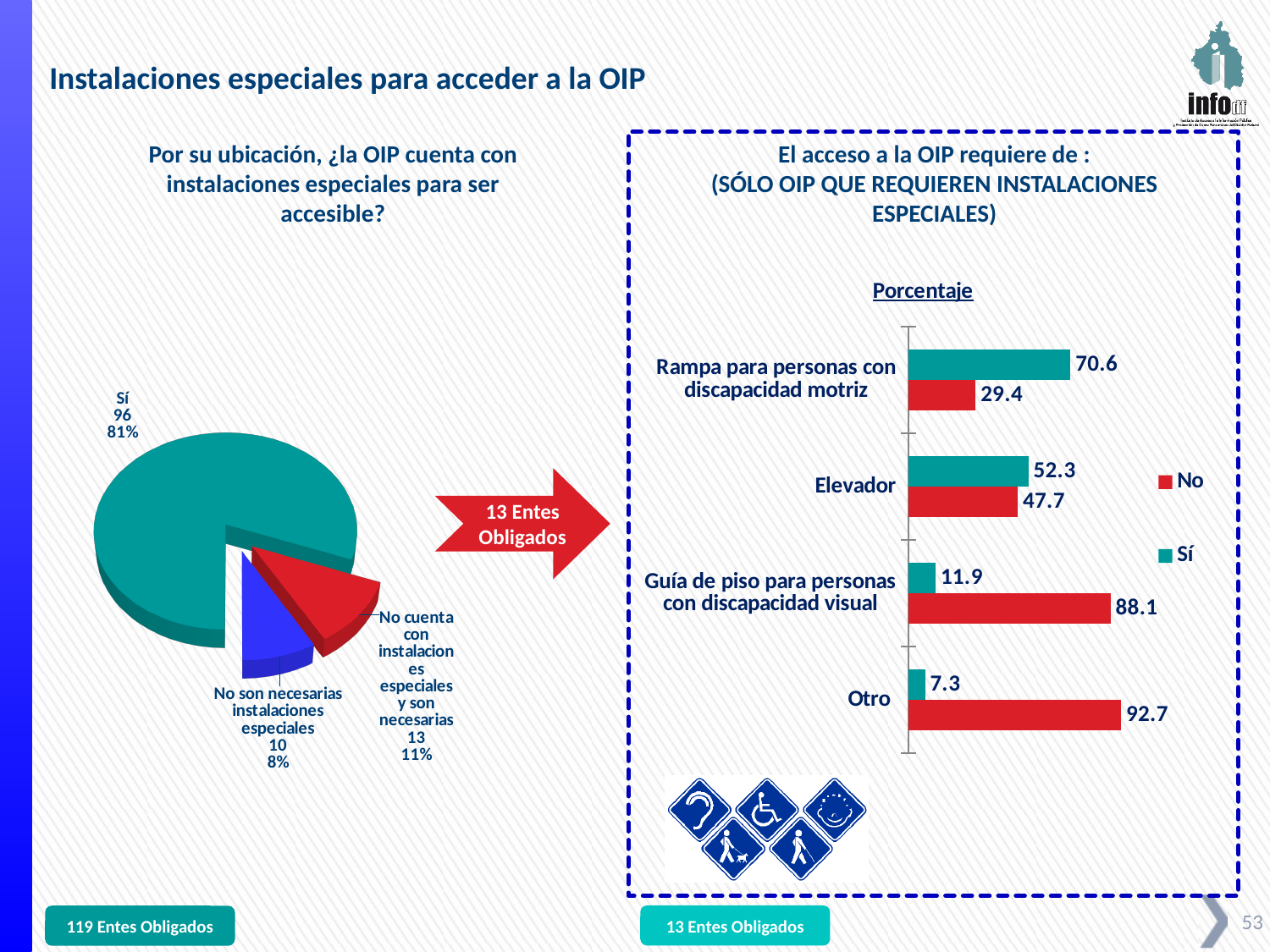
In the bar chart on the right, which category has the lowest 'Sí' value? Otro In the bar chart on the right, is the 'Sí' value for 'Elevador' larger or smaller than its 'No' value? larger In the pie chart on the left, how many slices are there? 3 In the pie chart on the left, what percentage share does the 'Sí' slice have? 81% What type of chart is shown on the right side of the slide? bar chart In the bar chart on the right, how many series does the legend list? 2 In the bar chart on the right, what is the 'No' value for 'Elevador'? 47.7 In the bar chart on the right, what is the difference between the 'No' and 'Sí' values for 'Guía de piso para personas con discapacidad visual'? 76.2 In the pie chart on the left, which slice is the smallest? No son necesarias instalaciones especiales In the bar chart on the right, what is the 'Sí' value for 'Rampa para personas con discapacidad motriz'? 70.6 In the pie chart on the left, how many entities are in the 'No son necesarias instalaciones especiales' slice? 10 In the bar chart on the right, which category has the highest 'No' value? Otro